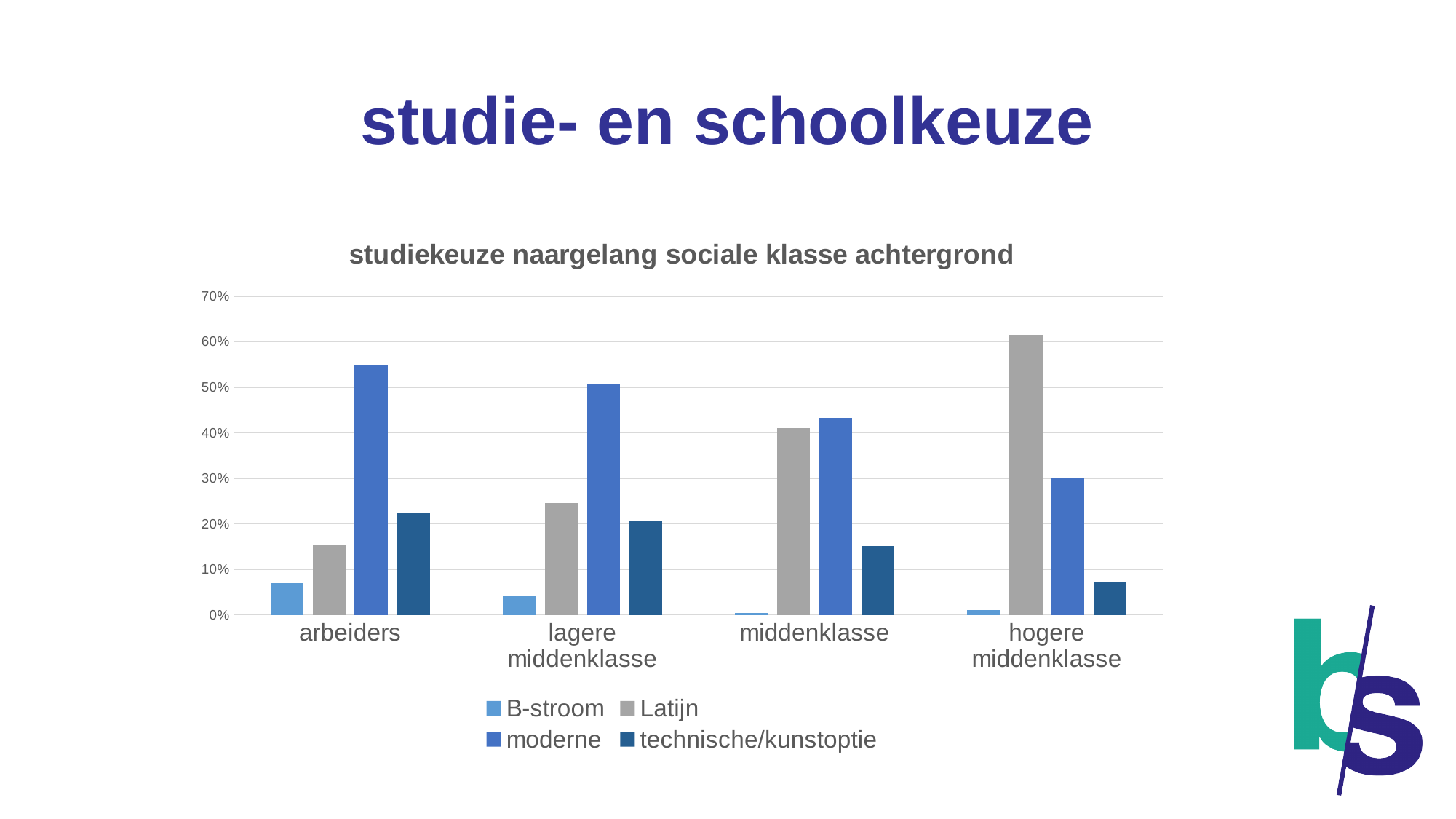
Is the value for moderne in the arbeiders category greater or less than 50%? greater For lagere middenklasse, which is larger: Latijn or technische/kunstoptie? Latijn Which series has the lowest value for hogere middenklasse? B-stroom Which series has the highest value for arbeiders? moderne How many social class categories are shown on the x axis? 4 Is the value for technische/kunstoptie in the hogere middenklasse category greater or less than 10%? less Is the value for Latijn in the hogere middenklasse category greater or less than 50%? greater Do the values for Latijn rise or fall from arbeiders to hogere middenklasse? rise What is the title of the chart? studiekeuze naargelang sociale klasse achtergrond Which category has the highest value for Latijn? hogere middenklasse What kind of chart is shown on the slide? bar chart How many series does the legend list? 4